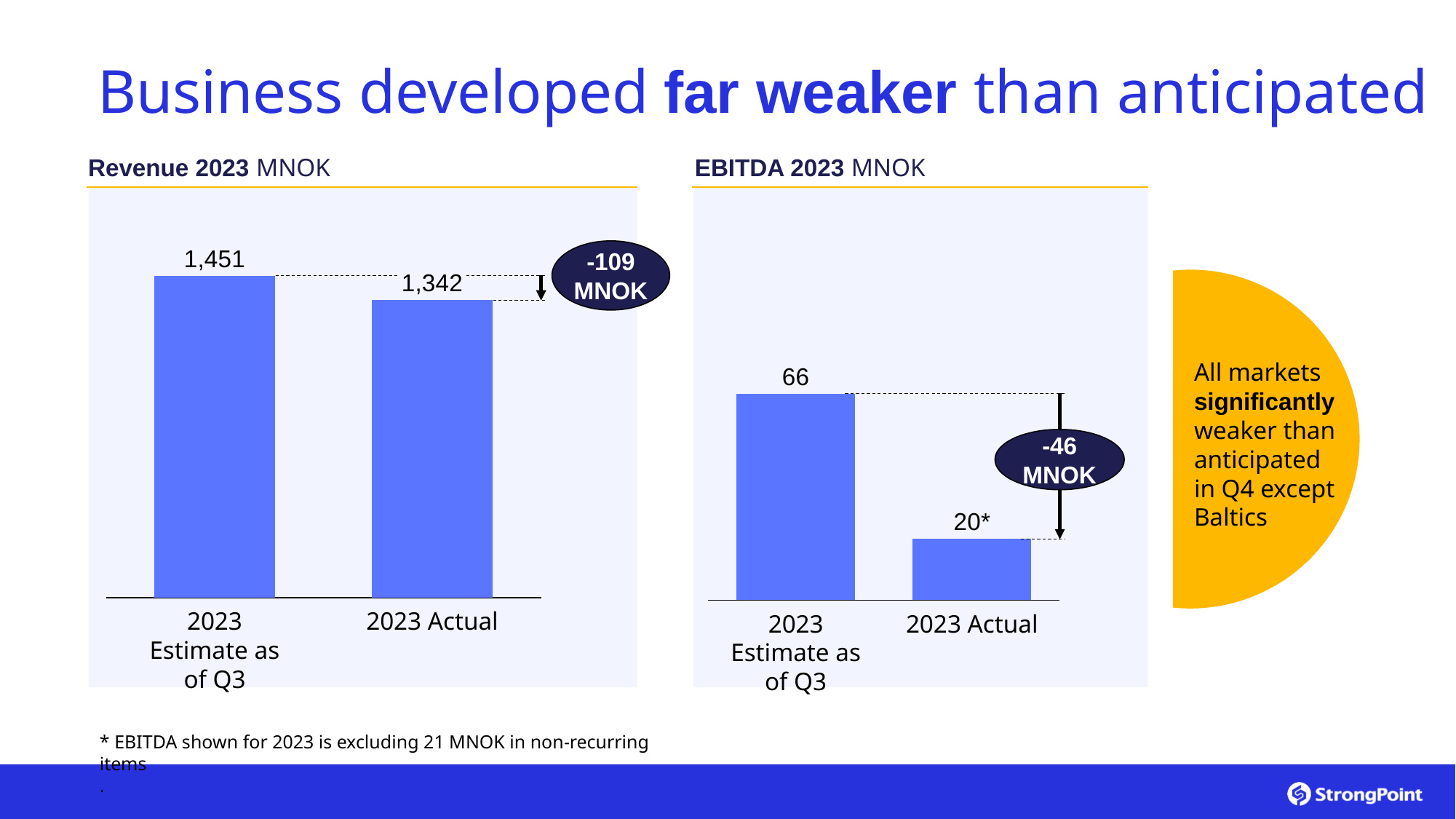
What is the title of the chart on the left side of the slide? Revenue 2023 MNOK In the EBITDA 2023 MNOK chart, what is the difference between the 2023 Estimate as of Q3 and 2023 Actual? 46 In the Revenue 2023 MNOK chart, what is the difference between the 2023 Estimate as of Q3 and 2023 Actual? 109 In the Revenue 2023 MNOK chart, what is the value for 2023 Estimate as of Q3? 1,451 In the EBITDA 2023 MNOK chart, which category has the lower value? 2023 Actual In the Revenue 2023 MNOK chart, what is the value for 2023 Actual? 1,342 In the EBITDA 2023 MNOK chart, what is the value for 2023 Estimate as of Q3? 66 How many bars are shown in the Revenue 2023 MNOK chart? 2 What type of chart is the EBITDA 2023 MNOK chart? bar chart In the Revenue 2023 MNOK chart, which category has the higher value? 2023 Estimate as of Q3 In the EBITDA 2023 MNOK chart, is the value for 2023 Estimate as of Q3 larger or smaller than the value for 2023 Actual? larger In the EBITDA 2023 MNOK chart, what is the value for 2023 Actual? 20*